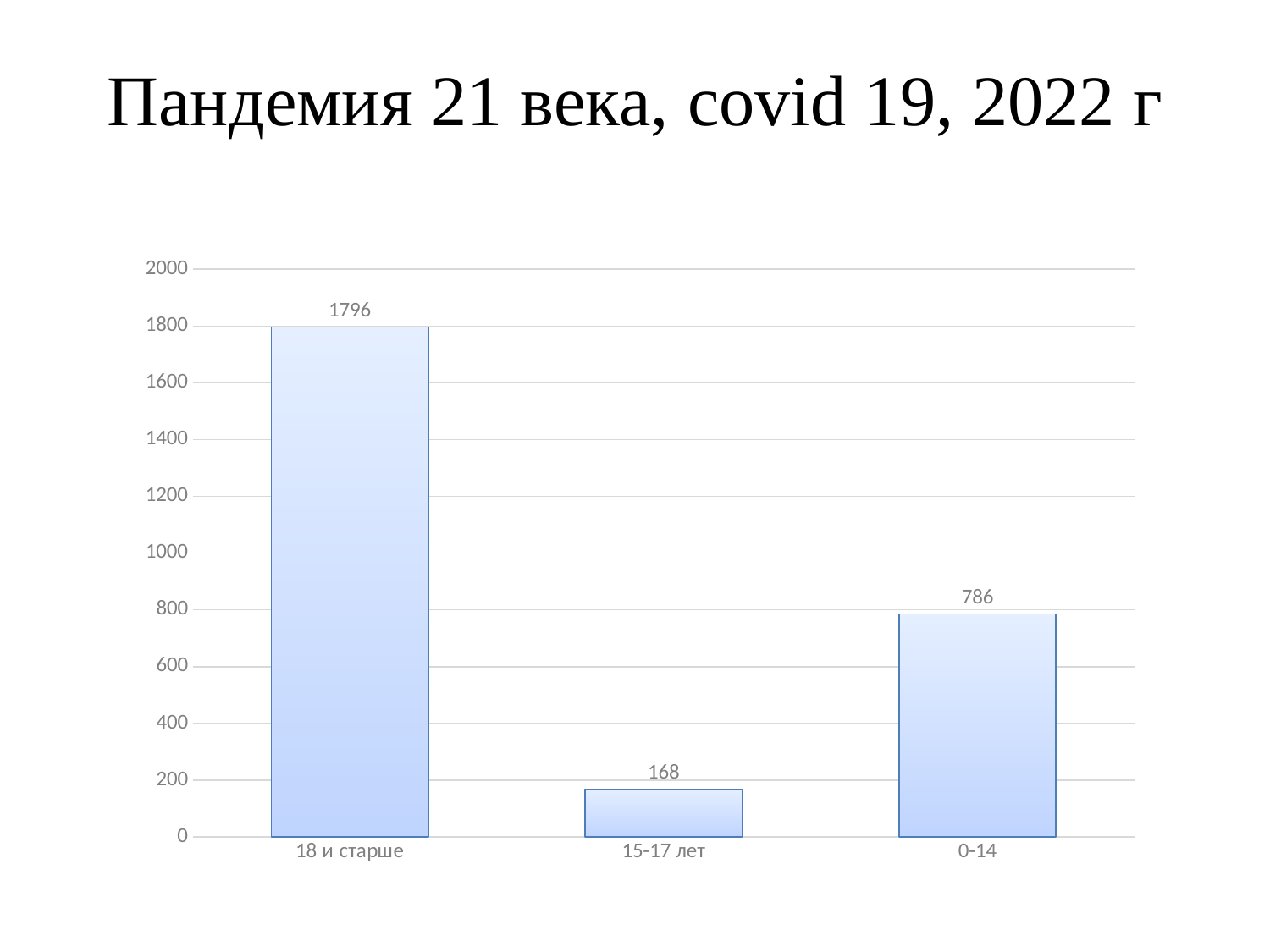
What is the value for the category "18 и старше"? 1796 Which category has the lowest value? 15-17 лет What is the value for the category "15-17 лет"? 168 How many categories are shown on the x axis? 3 What is the difference between the values for "18 и старше" and "0-14"? 1010 Which is larger, the value for "0-14" or the value for "15-17 лет"? 0-14 What is the value for the category "0-14"? 786 What is the difference between the values for "0-14" and "15-17 лет"? 618 Is the value for "0-14" greater or less than 1000? less What kind of chart is shown on the slide? bar chart What is the title of the slide? Пандемия 21 века, covid 19, 2022 г Which category has the highest value? 18 и старше